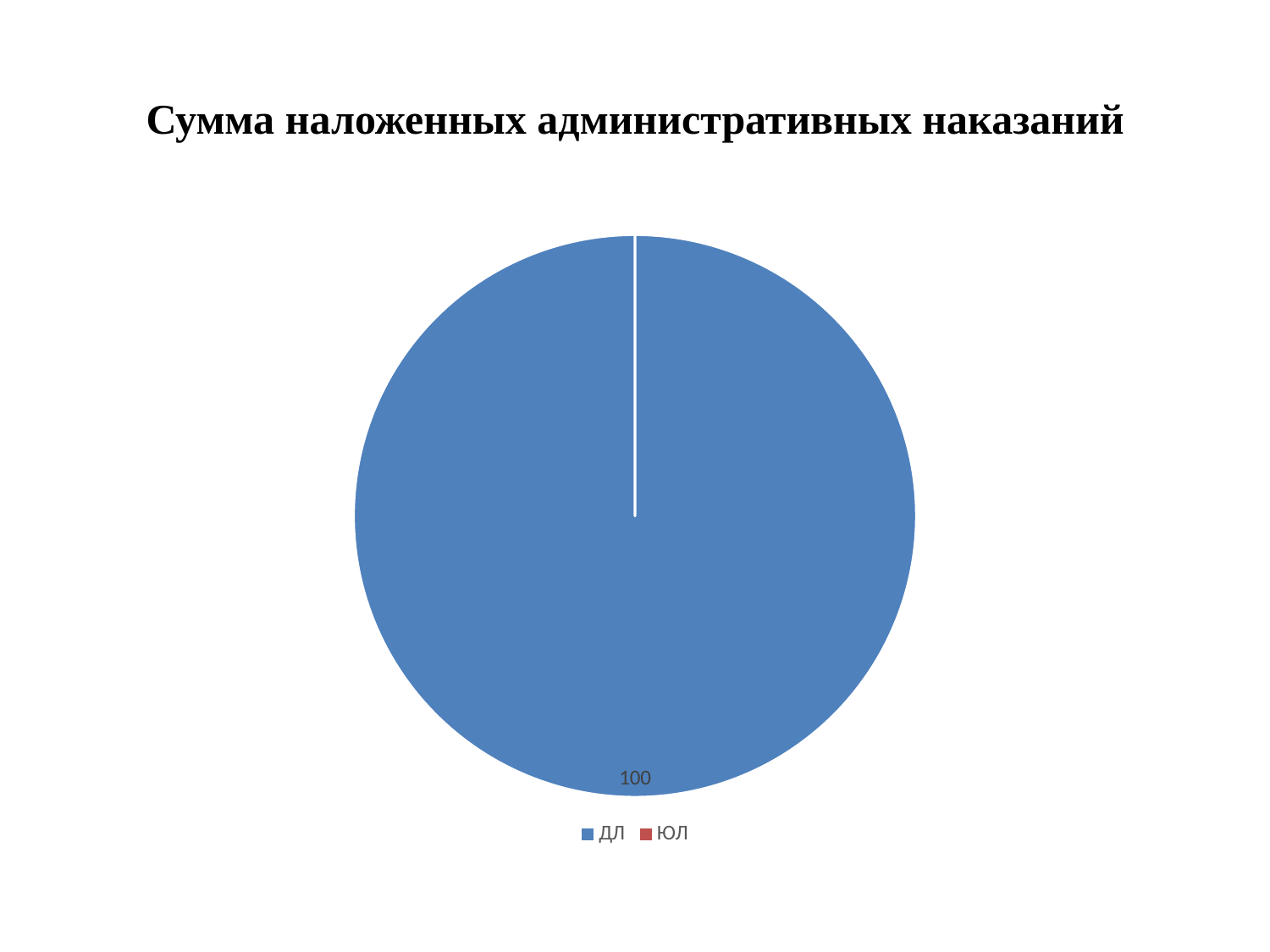
What is the title of the chart? Сумма наложенных административных наказаний How many entries does the chart legend list? 2 Which category has the smallest slice of the pie? ЮЛ What value is labelled on the ДЛ slice of the pie? 100 Which category has the largest slice of the pie? ДЛ How many slices are visibly drawn in the pie? 1 What colour is the ДЛ slice in the pie chart? blue Which is larger, the slice for ДЛ or the slice for ЮЛ? ДЛ What kind of chart is shown on the slide? pie chart